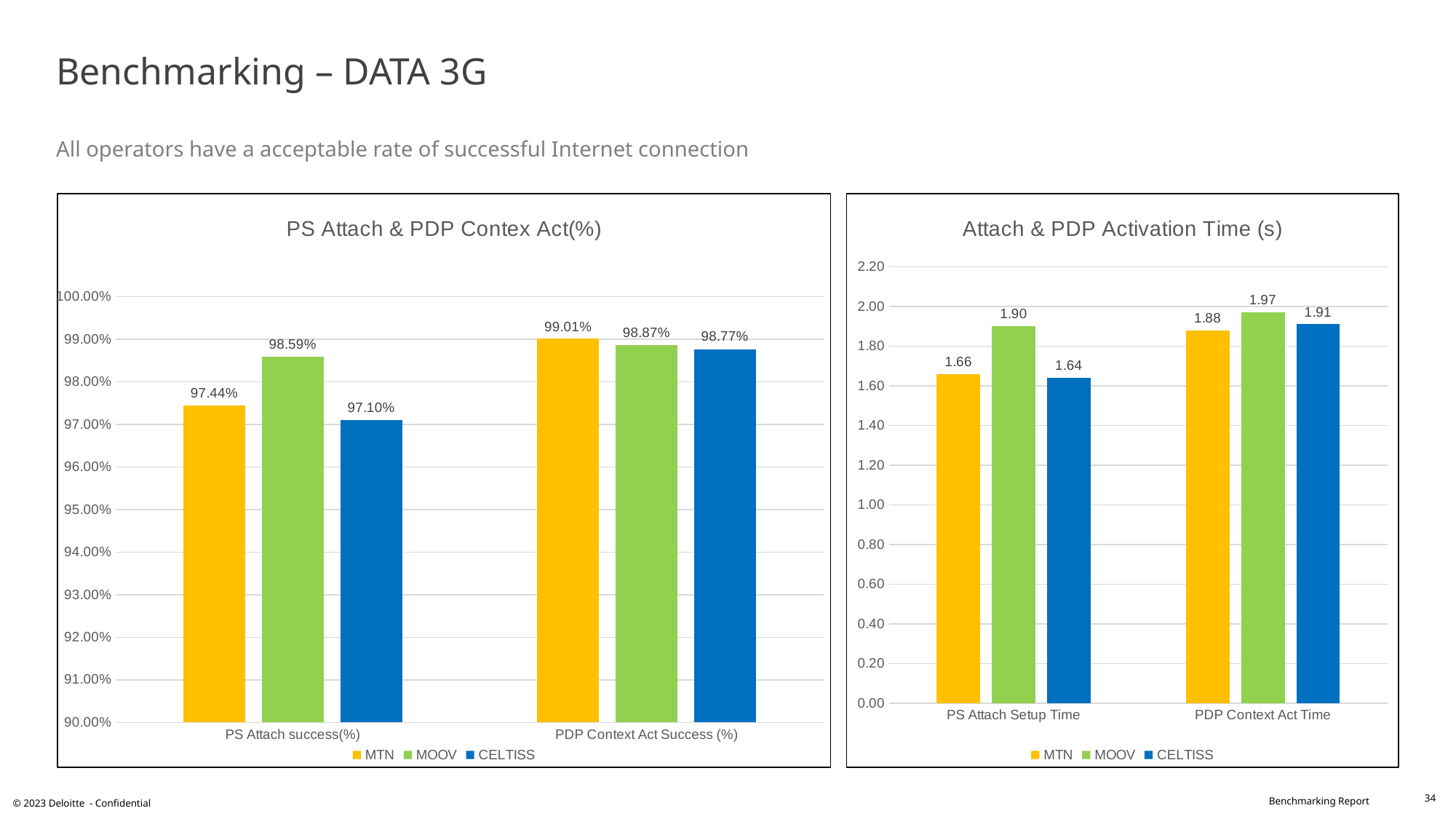
In the 'PS Attach & PDP Contex Act(%)' chart, which operator has the lowest PS Attach success(%)? CELTISS In the 'Attach & PDP Activation Time (s)' chart, which operator has the highest PDP Context Act Time? MOOV In the 'PS Attach & PDP Contex Act(%)' chart, what is the difference between MOOV and CELTISS in PS Attach success(%)? 1.49% In the 'PS Attach & PDP Contex Act(%)' chart, what is the value for MTN in PS Attach success(%)? 97.44% In the 'Attach & PDP Activation Time (s)' chart, what is the PDP Context Act Time for MTN? 1.88 In the 'Attach & PDP Activation Time (s)' chart, what is the PS Attach Setup Time for MOOV? 1.90 In the 'Attach & PDP Activation Time (s)' chart, what is the difference between MOOV and CELTISS in PS Attach Setup Time? 0.26 What kind of chart is the 'Attach & PDP Activation Time (s)' chart? Bar chart In the 'PS Attach & PDP Contex Act(%)' chart, which operator has the highest PS Attach success(%)? MOOV In the 'PS Attach & PDP Contex Act(%)' chart, how many series does the legend list? 3 In the 'Attach & PDP Activation Time (s)' chart, how many categories are shown on the x axis? 2 In the 'PS Attach & PDP Contex Act(%)' chart, what is the value for CELTISS in PDP Context Act Success (%)? 98.77%